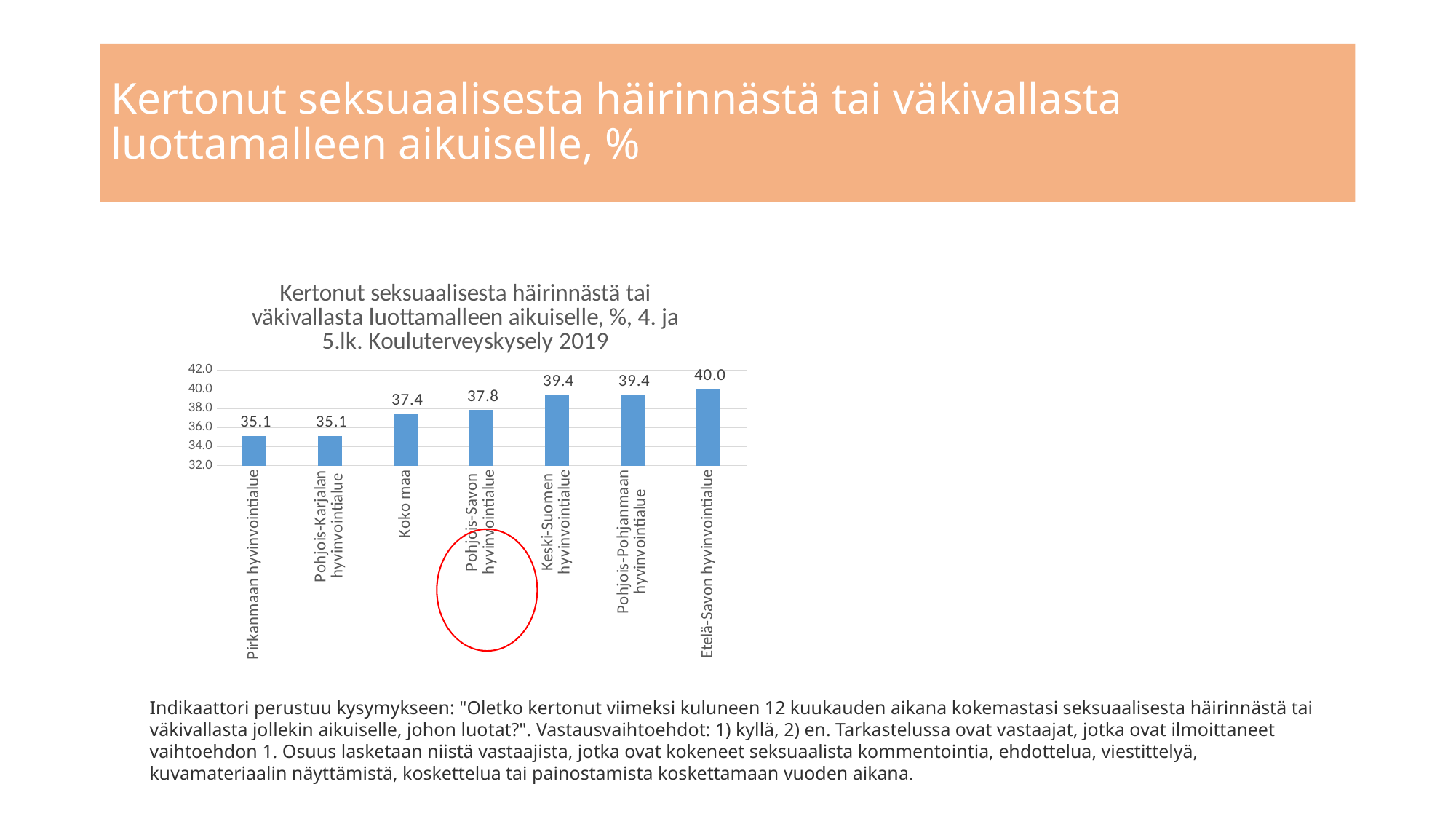
What is the value for Etelä-Savon hyvinvointialue? 40.0 Do the values rise or fall from left to right along the x axis? Rise What is the lowest value shown in the chart? 35.1 What is the value for Koko maa? 37.4 What kind of chart is shown on the slide? Bar chart What is the value for Pirkanmaan hyvinvointialue? 35.1 How many categories are shown in the chart? 7 Which category has the highest value? Etelä-Savon hyvinvointialue What is the difference between the values for Etelä-Savon hyvinvointialue and Pirkanmaan hyvinvointialue? 4.9 What is the difference between the values for Pohjois-Savon hyvinvointialue and Koko maa? 0.4 What is the value for Pohjois-Savon hyvinvointialue? 37.8 Which is larger, the value for Keski-Suomen hyvinvointialue or the value for Koko maa? Keski-Suomen hyvinvointialue